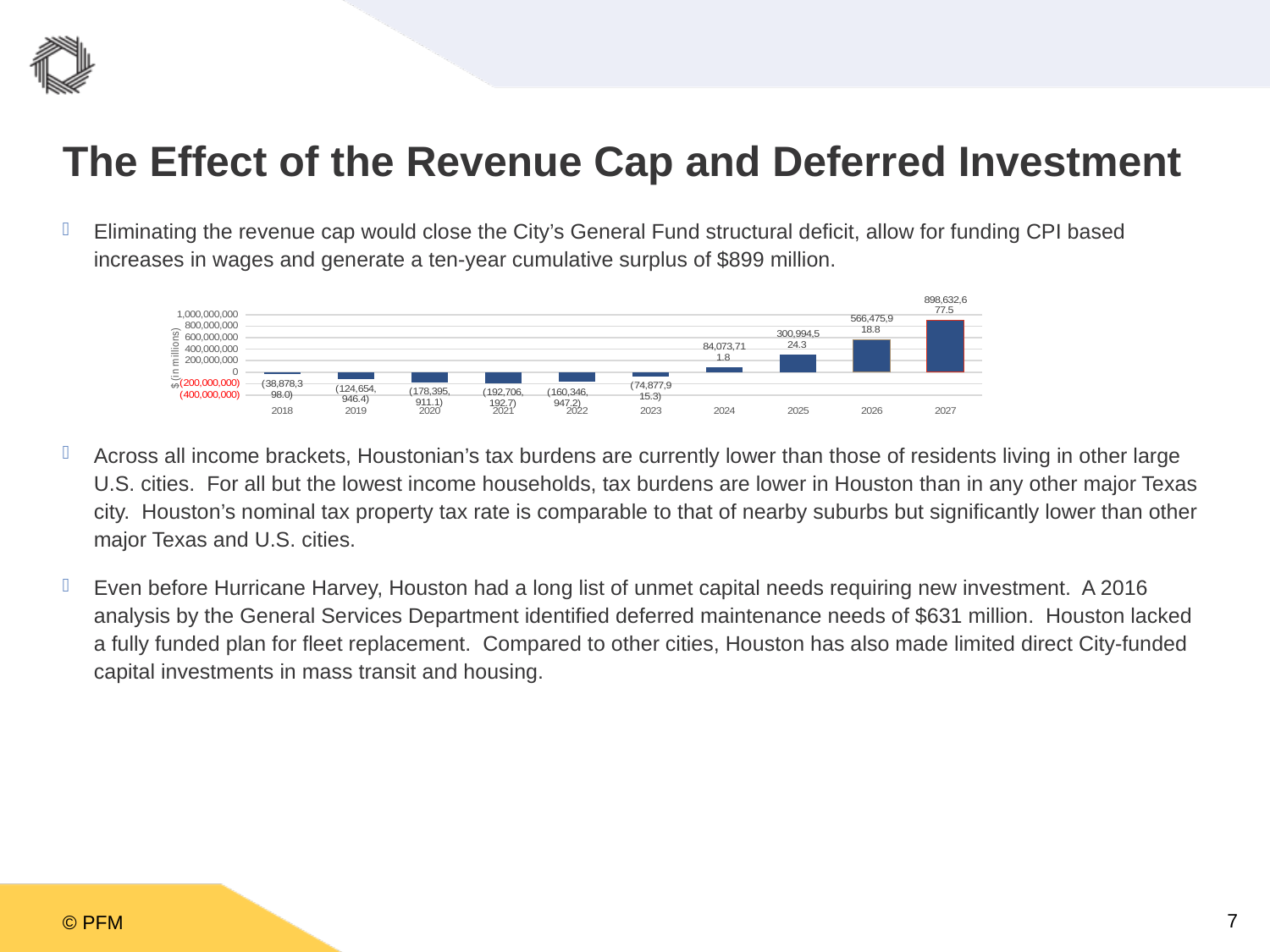
Is the value for 2026 greater or less than 400,000,000? greater Which year has the lowest (most negative) value in the chart? 2021 Which year has the highest value in the chart? 2027 Which year has the larger value, 2024 or 2025? 2025 What is the value shown for 2027 in the chart? 898,632,677.5 How many years are plotted in the chart? 10 What kind of chart is shown on the slide? Bar chart What is the value shown for 2021 in the chart? (192,706,192.7) What is the value shown for 2025 in the chart? 300,994,524.3 Do the values rise or fall from 2023 to 2027? Rise What is the value shown for 2024 in the chart? 84,073,711.8 What is the difference between the values for 2027 and 2026? 332,156,758.7